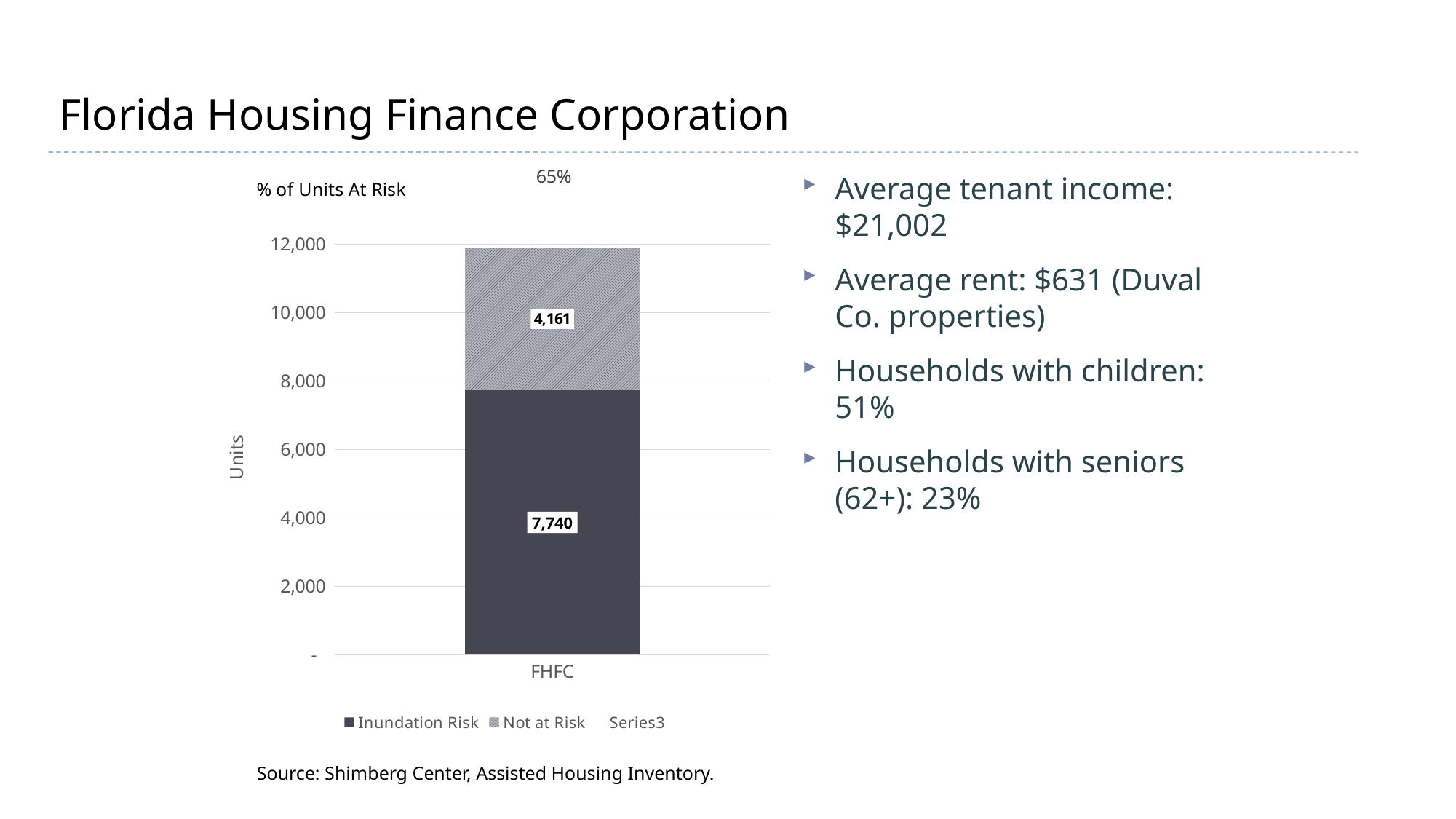
What is the label of the y axis of the chart? Units What percentage of units at risk is shown above the chart? 65% How many categories are shown on the x axis of the chart? 1 Which series has the larger value for FHFC, Inundation Risk or Not at Risk? Inundation Risk What is the value for Not at Risk for FHFC? 4,161 What is the difference between the Inundation Risk and Not at Risk values for FHFC? 3,579 Is the total height of the FHFC bar greater or less than 10,000? greater What kind of chart is shown on the slide? Stacked bar chart How many series does the chart legend list? 3 Is the Inundation Risk value for FHFC greater or less than 8,000? less What is the value for Inundation Risk for FHFC? 7,740 What is the total of the stacked bar for FHFC? 11,901